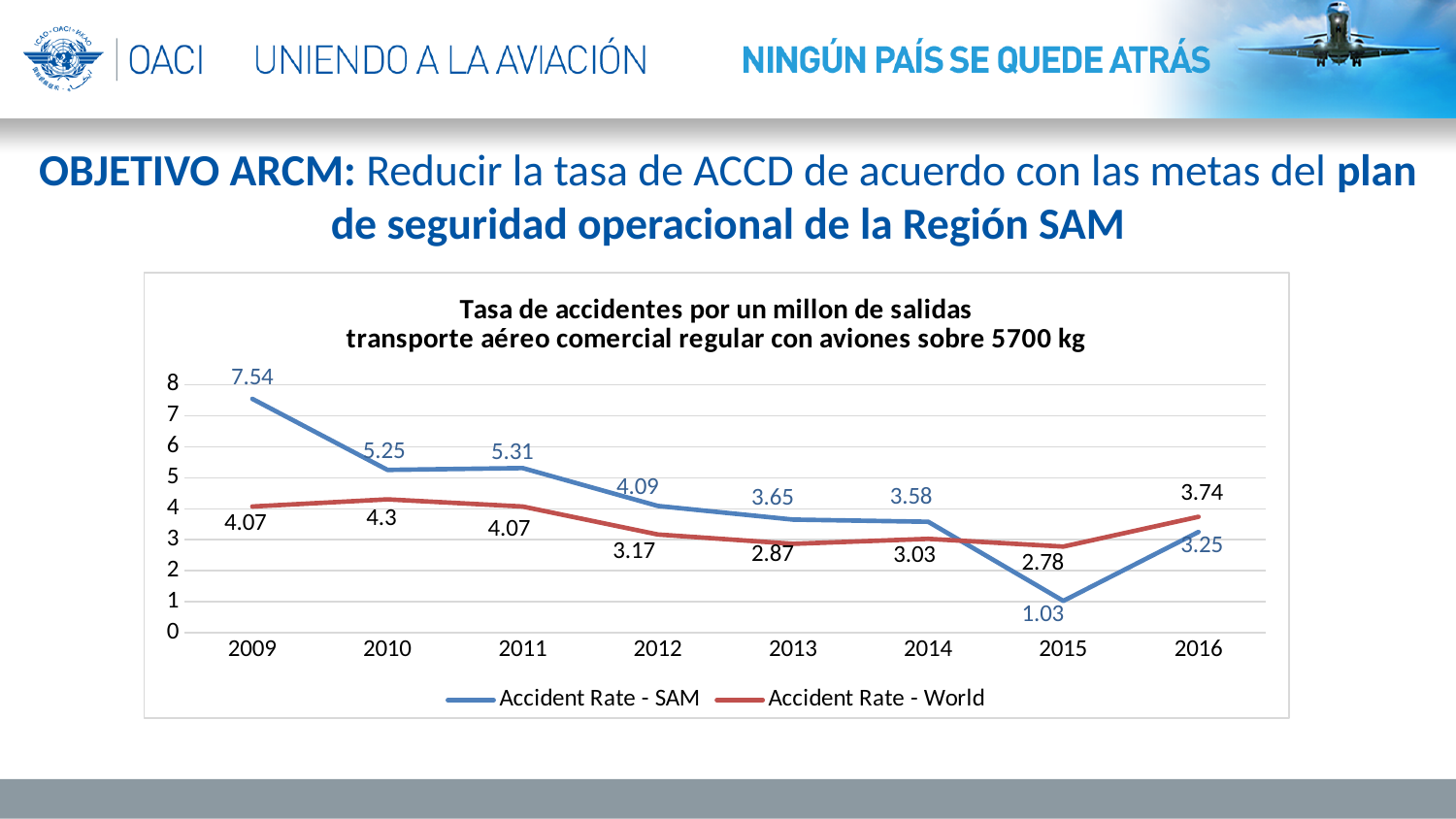
What is the Accident Rate - SAM value for 2009? 7.54 What is the Accident Rate - World value for 2010? 4.3 What kind of chart is shown on the slide? Line chart What is the Accident Rate - World value for 2016? 3.74 In which year is the Accident Rate - World lowest? 2015 What is the Accident Rate - SAM value for 2015? 1.03 What is the difference between the Accident Rate - SAM and the Accident Rate - World in 2009? 3.47 Which series has the larger value in 2016, Accident Rate - SAM or Accident Rate - World? Accident Rate - World Does the Accident Rate - SAM rise or fall from 2009 to 2015? Fall In which year is the Accident Rate - SAM highest? 2009 How many years are shown on the x axis? 8 How many series does the legend list? 2